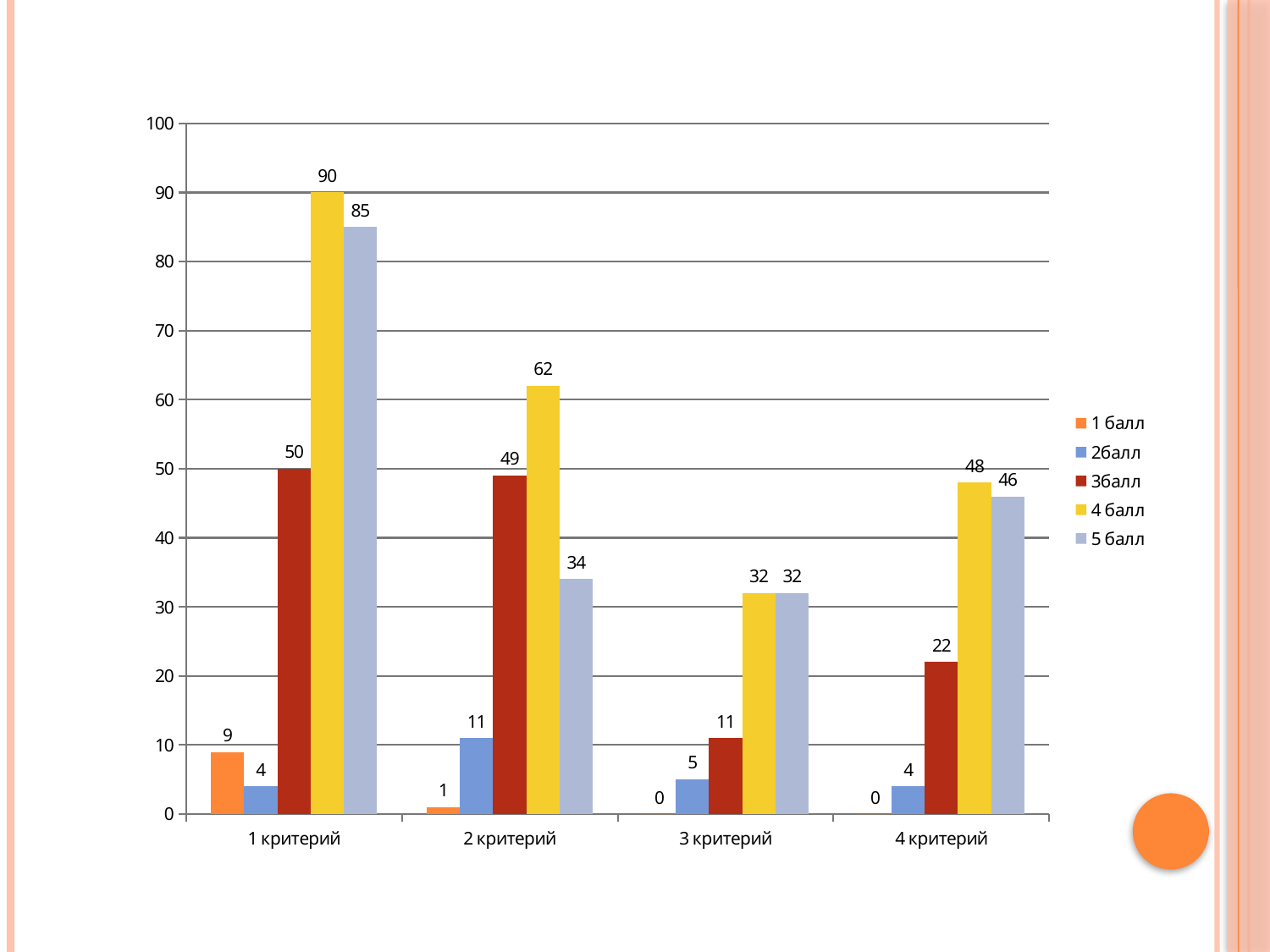
What is the value for 3балл in 2 критерий? 49 What is the value for 1 балл in 3 критерий? 0 What is the difference between the 4 балл and 5 балл values in 2 критерий? 28 What colour are the bars for 4 балл? yellow Which category has the highest value for 4 балл? 1 критерий What is the value for 4 балл in 1 критерий? 90 How many categories are shown on the x axis? 4 How many series does the legend list? 5 Which category has the lowest value for 5 балл? 3 критерий What kind of chart is shown on the slide? bar chart Which is larger in 4 критерий: the value for 3балл or the value for 5 балл? 5 балл What is the value for 5 балл in 4 критерий? 46